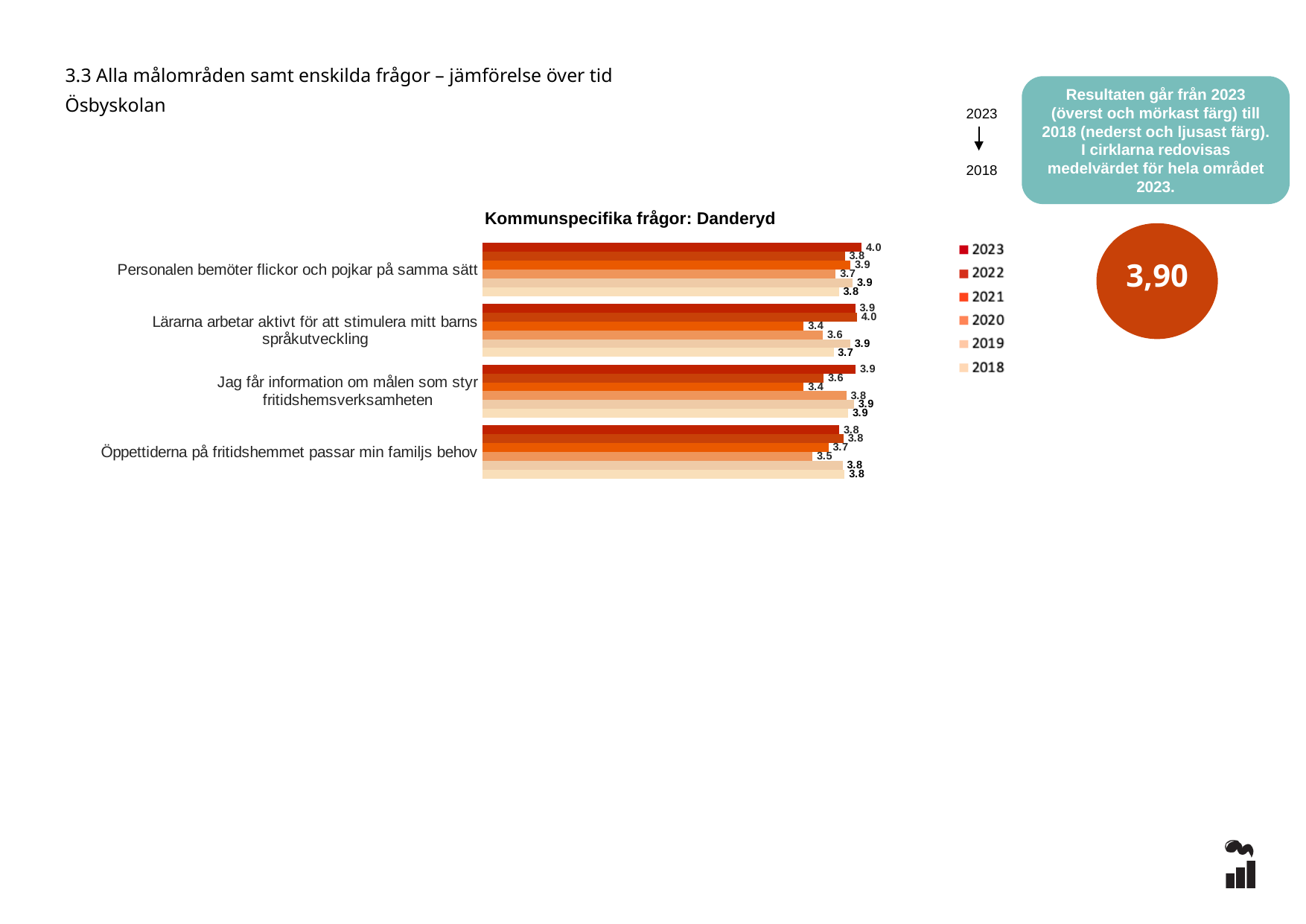
How many categories (questions) are shown in the chart? 4 Which year has the lowest value for "Jag får information om målen som styr fritidshemsverksamheten"? 2021 What is the 2018 value for "Jag får information om målen som styr fritidshemsverksamheten"? 3.9 Which category has the highest 2023 value? Personalen bemöter flickor och pojkar på samma sätt What is the 2020 value for "Öppettiderna på fritidshemmet passar min familjs behov"? 3.5 For "Öppettiderna på fritidshemmet passar min familjs behov", which is larger: the 2023 value or the 2020 value? 2023 What is the 2021 value for "Lärarna arbetar aktivt för att stimulera mitt barns språkutveckling"? 3.4 What is the 2023 value for "Personalen bemöter flickor och pojkar på samma sätt"? 4.0 How many series does the legend list? 6 What is the mean value shown in the circle for the whole area in 2023? 3,90 What kind of chart is shown on the slide? Bar chart What is the difference between the 2022 and 2021 values for "Lärarna arbetar aktivt för att stimulera mitt barns språkutveckling"? 0.6